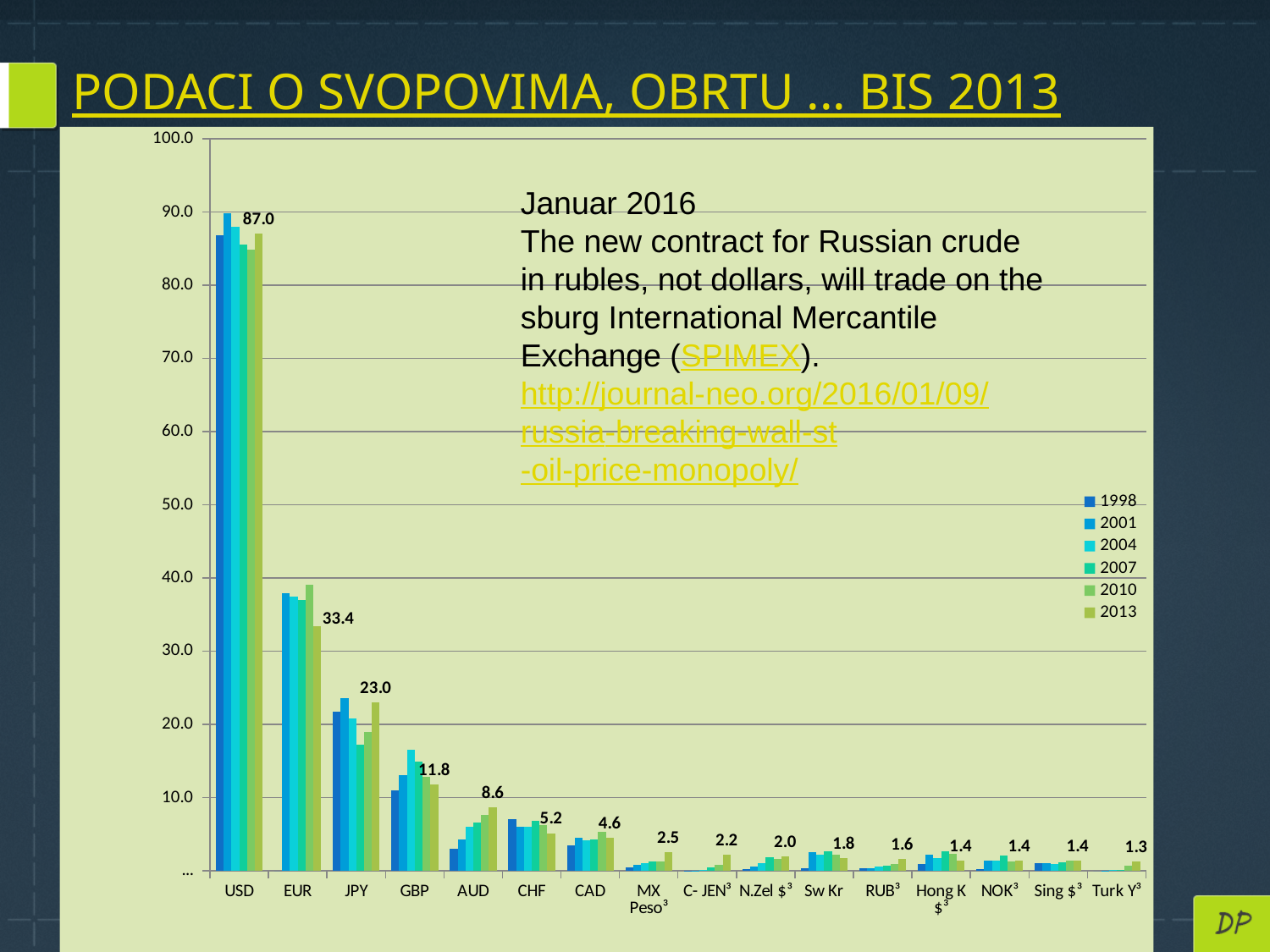
Is the 1998 value for USD greater or less than 80.0? greater What is the 2013 value for JPY? 23.0 How many series does the legend list? 6 Which has the larger 2013 value, GBP or AUD? GBP What is the difference between the 2013 values for USD and EUR? 53.6 What is the 2013 value for EUR? 33.4 Which currency has the lowest 2013 value? Turk Y Which currency has the highest 2013 value? USD What is the 2013 value for AUD? 8.6 What is the 2013 value for USD? 87.0 What kind of chart is shown on the slide? bar chart How many currency categories are shown on the x axis? 16